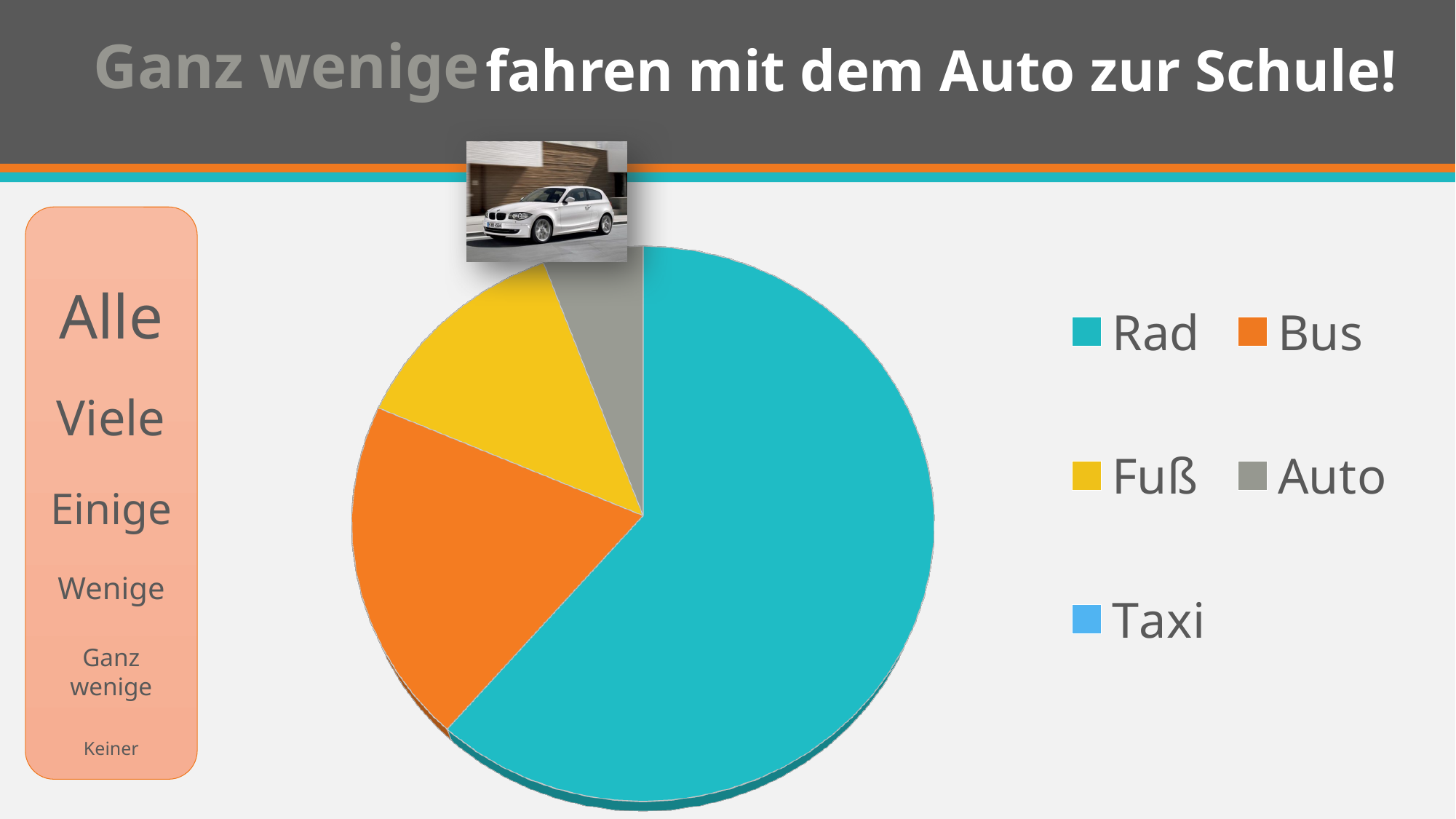
Which category has the largest slice of the pie chart? Rad How many slices are visible in the pie chart? 4 Which of the visible slices in the pie chart is the smallest? Auto Which legend entry has no visible slice in the pie chart? Taxi Which slice is larger in the pie chart, Rad or Bus? Rad What colour is the Bus slice in the pie chart? orange How many entries does the legend of the pie chart list? 5 Does the Rad slice take up more or less than half of the pie chart? more Which slice is larger in the pie chart, Fuß or Auto? Fuß Which slice is larger in the pie chart, Bus or Fuß? Bus What kind of chart is shown on the slide? pie chart